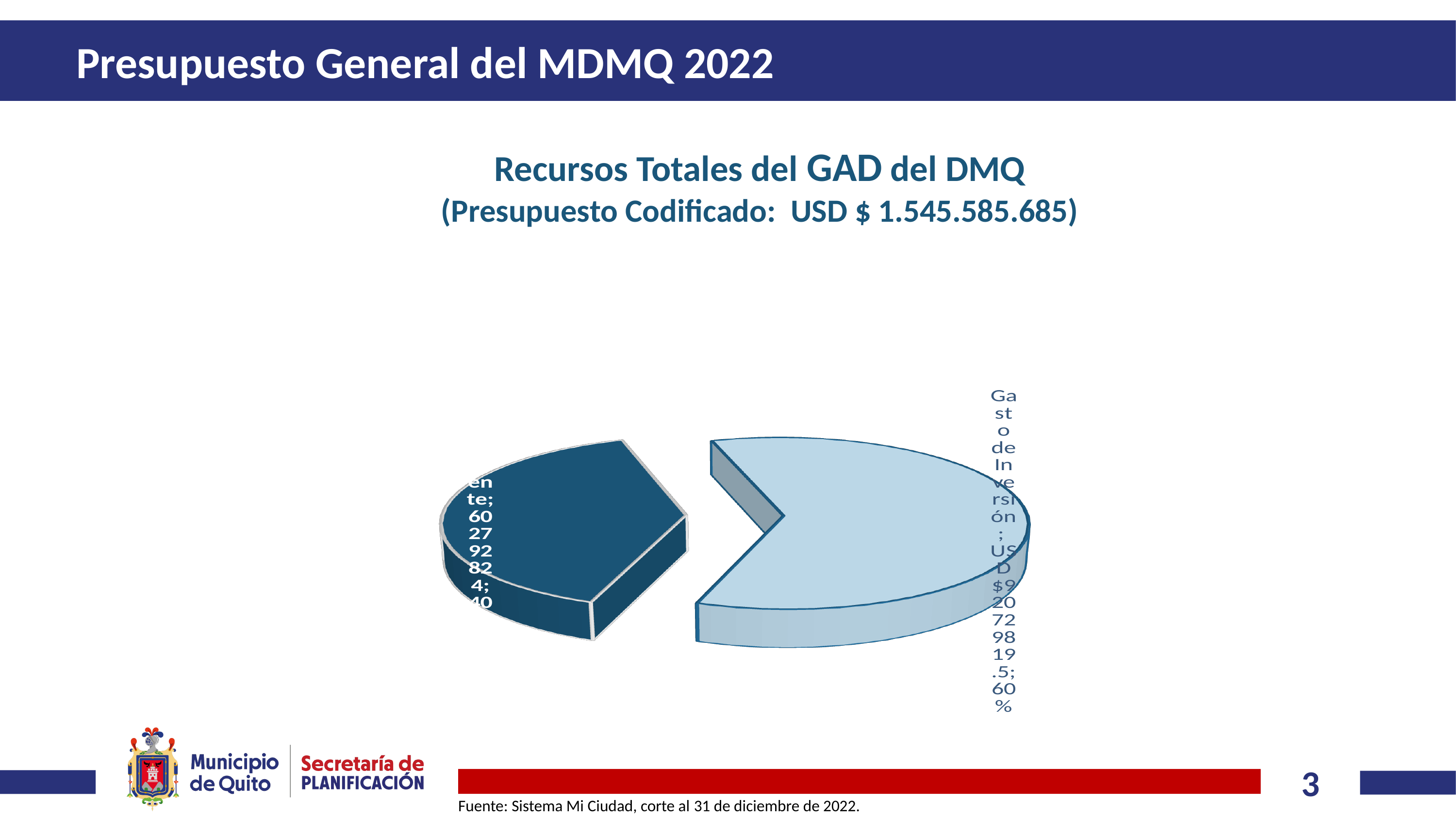
What kind of chart is shown on the slide? pie chart What is the title of the chart? Recursos Totales del GAD del DMQ Is the Gasto de Inversión slice greater or less than 50% of the pie? greater Which slice of the pie chart is the largest? Gasto de Inversión How many slices does the pie chart have? 2 What is the value shown for Gasto de Inversión? USD $920729819.5 What total Presupuesto Codificado is stated in the chart subtitle? USD $ 1.545.585.685 What share of the pie does the Gasto de Inversión slice represent? 60% Which slice is larger, the light blue slice or the dark blue slice? the light blue slice